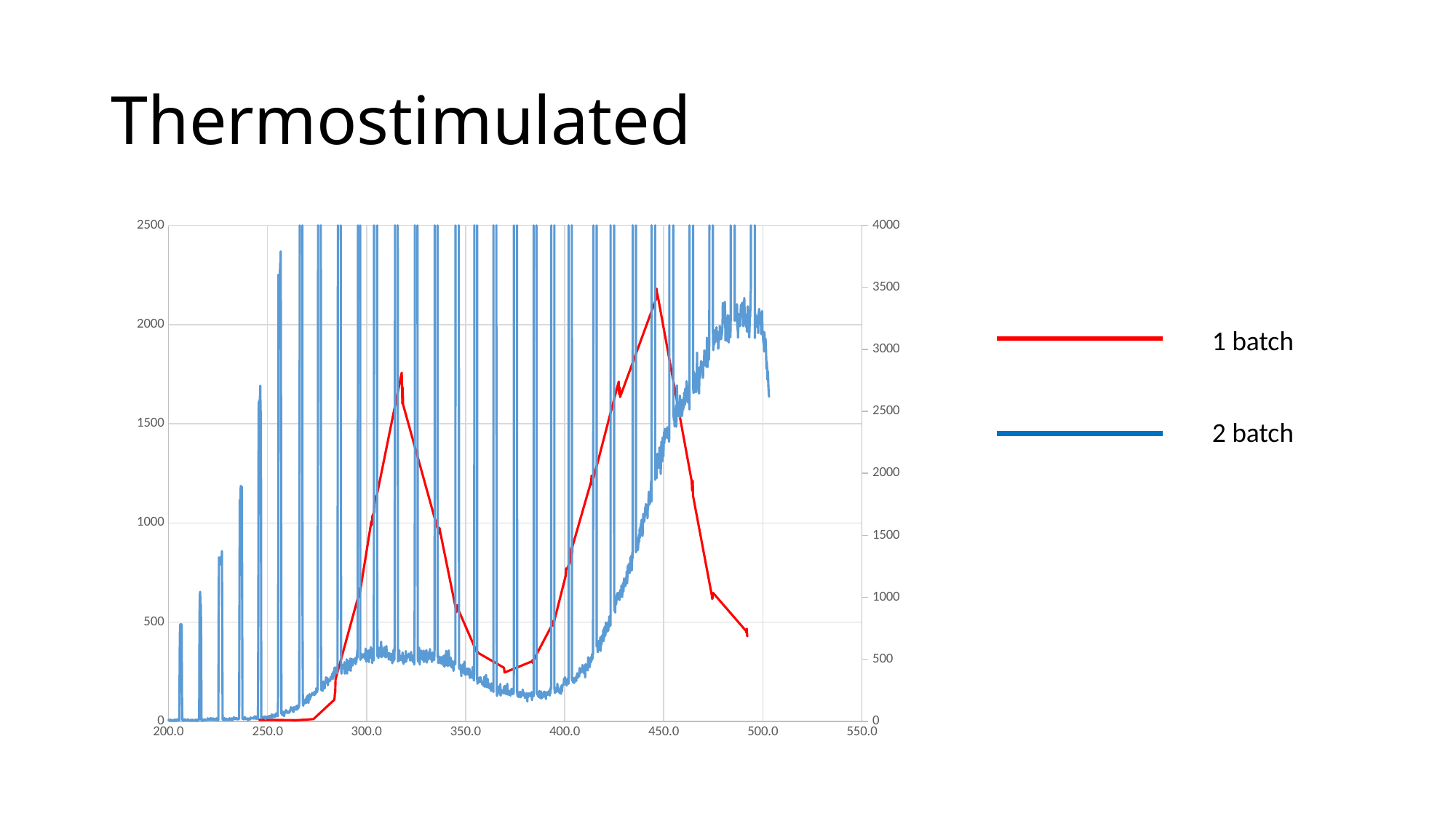
What is the highest tick value shown on the right vertical axis? 4000 What kind of chart is shown on the slide? line chart What is the highest tick value shown on the left vertical axis? 2500 Does the "1 batch" line rise or fall between x = 400 and x = 445? rise What is the largest tick value shown on the horizontal axis? 550.0 What is the title of the slide containing the chart? Thermostimulated Does the "1 batch" line rise or fall between x = 320 and x = 370? fall Which colour is used for the "1 batch" series? red Is the value of the "2 batch" line at x = 500.0 greater or less than 1500? greater Is the value of the "1 batch" line at x = 250.0 greater or less than 500? less Which of the two peaks of the "1 batch" line is higher, the one near x = 315 or the one near x = 445? the one near x = 445 How many series does the legend list? 2